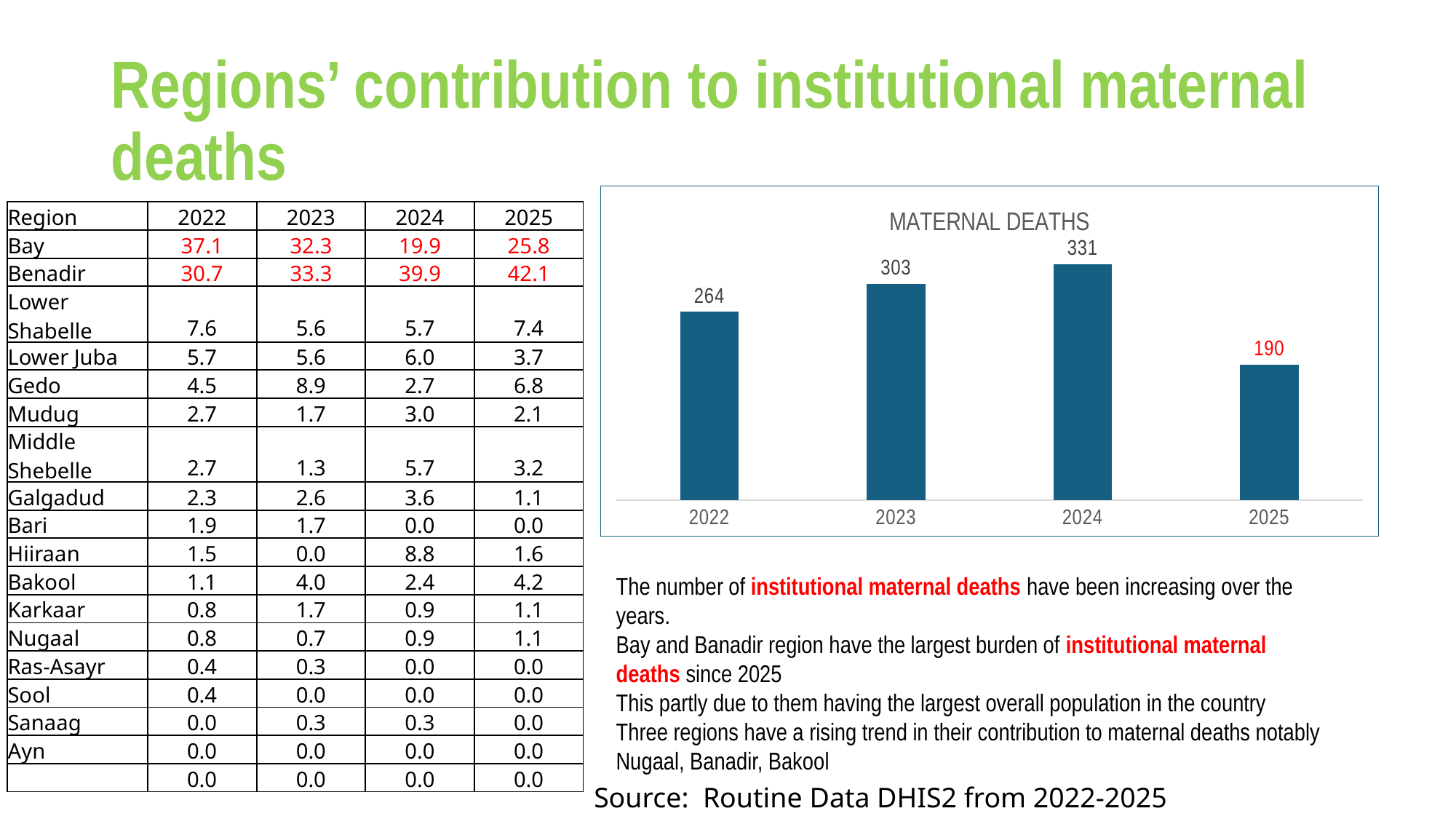
How many years are shown in the MATERNAL DEATHS chart? 4 What is the title of the chart on the slide? MATERNAL DEATHS Do the maternal deaths rise or fall from 2022 to 2024? rise What is the value for 2024 in the MATERNAL DEATHS chart? 331 What kind of chart is the MATERNAL DEATHS chart? bar chart What is the difference between the maternal deaths in 2024 and 2022? 67 Which year has the lowest number of maternal deaths in the chart? 2025 Which year has more maternal deaths, 2023 or 2025? 2023 Which year has the highest number of maternal deaths in the chart? 2024 What is the value for 2025 in the MATERNAL DEATHS chart? 190 What is the difference between the maternal deaths in 2023 and 2025? 113 What is the value for 2022 in the MATERNAL DEATHS chart? 264